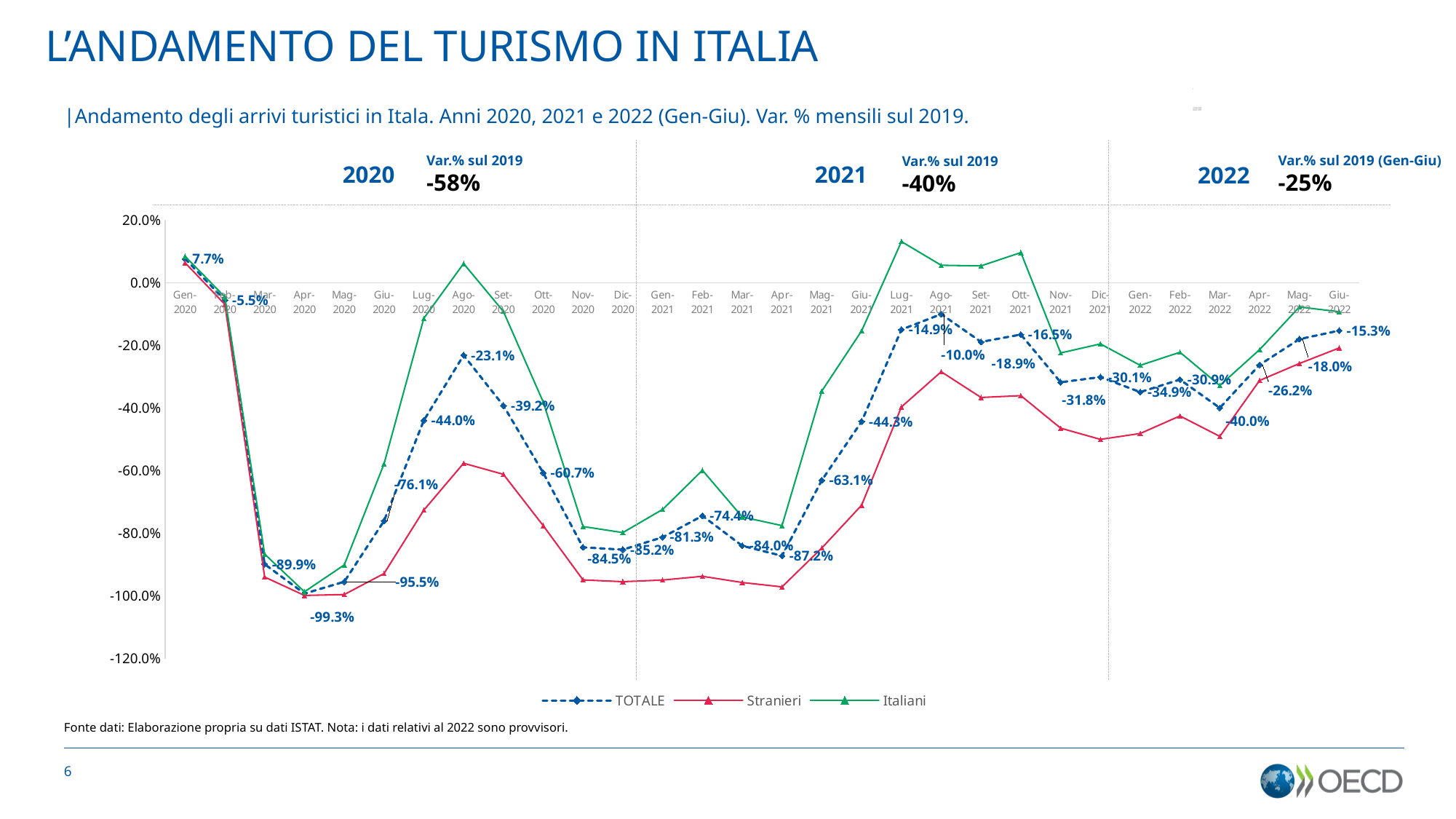
Which is larger, the TOTALE value for Feb-2022 or for Mar-2022? Feb-2022 In which month does the TOTALE series reach its highest value? Gen-2020 In which month does the TOTALE series reach its lowest value? Apr-2020 How many series does the legend list? 3 Is the Italiani value for Lug-2021 greater or less than 0.0%? greater What annual Var.% sul 2019 is shown for 2021? -40% What is the TOTALE value for Ago-2021? -10.0% What is the TOTALE value for Apr-2020? -99.3% What is the difference between the TOTALE values for Ago-2020 (-23.1%) and Lug-2020 (-44.0%)? 20.9 percentage points What kind of chart is shown on the slide? line chart Does the TOTALE series rise or fall from Apr-2020 to Ago-2020? rise What is the TOTALE value for Giu-2022? -15.3%